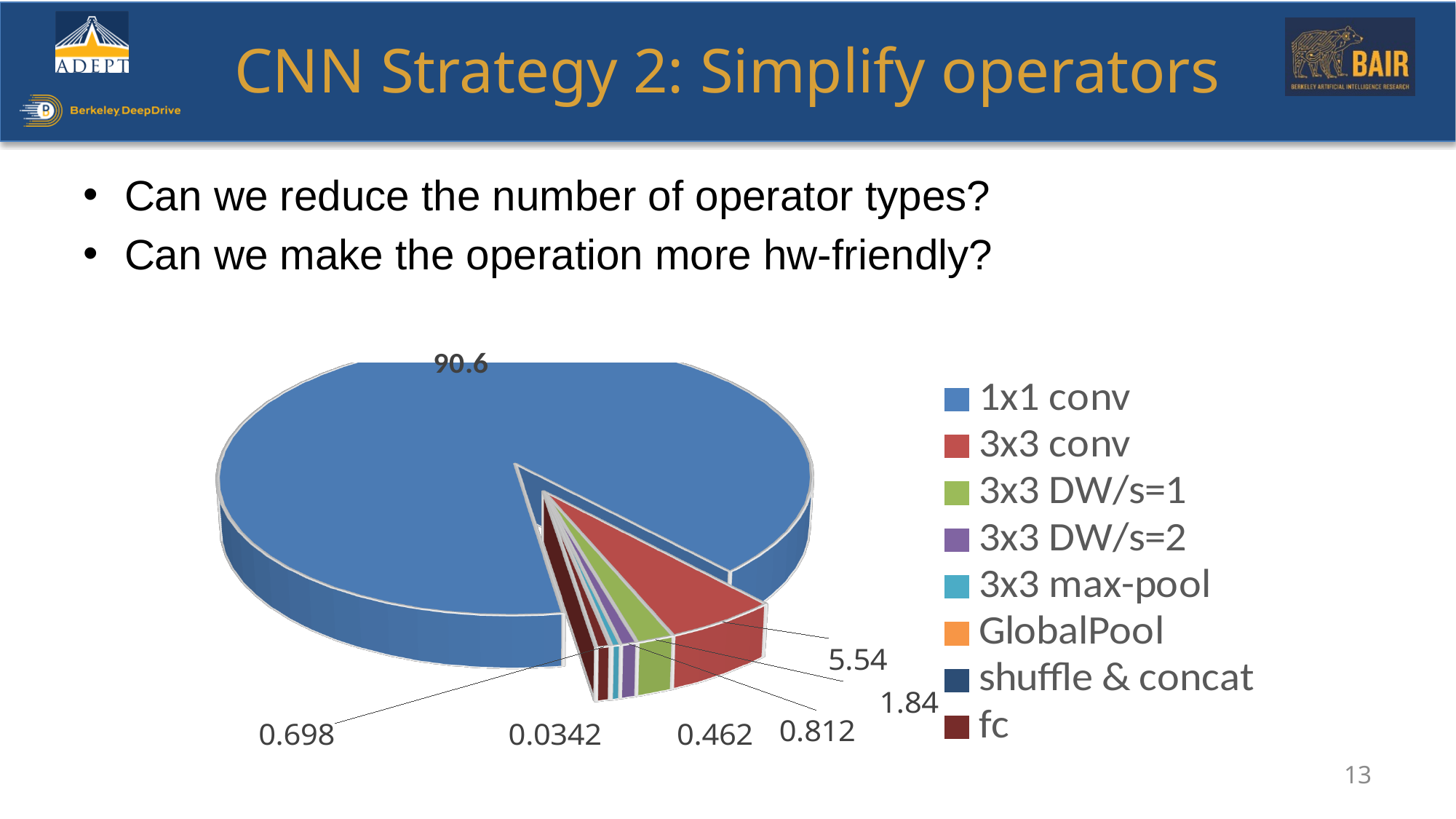
What is the smallest data label value shown on the pie chart? 0.0342 Which operator type has the largest slice in the pie chart? 1x1 conv What value is labelled on the 3x3 conv slice of the pie chart? 5.54 What colour is the 1x1 conv slice in the pie chart? blue How many entries does the chart's legend list? 8 Which legend entry is listed last in the pie chart's legend? fc What is the difference between the 1x1 conv value and the 3x3 conv value in the pie chart? 85.06 What is the largest data label value shown on the pie chart? 90.6 What kind of chart is shown on the slide? pie chart What value is labelled on the 1x1 conv slice of the pie chart? 90.6 Which is larger in the pie chart, the 1x1 conv slice or the 3x3 conv slice? 1x1 conv